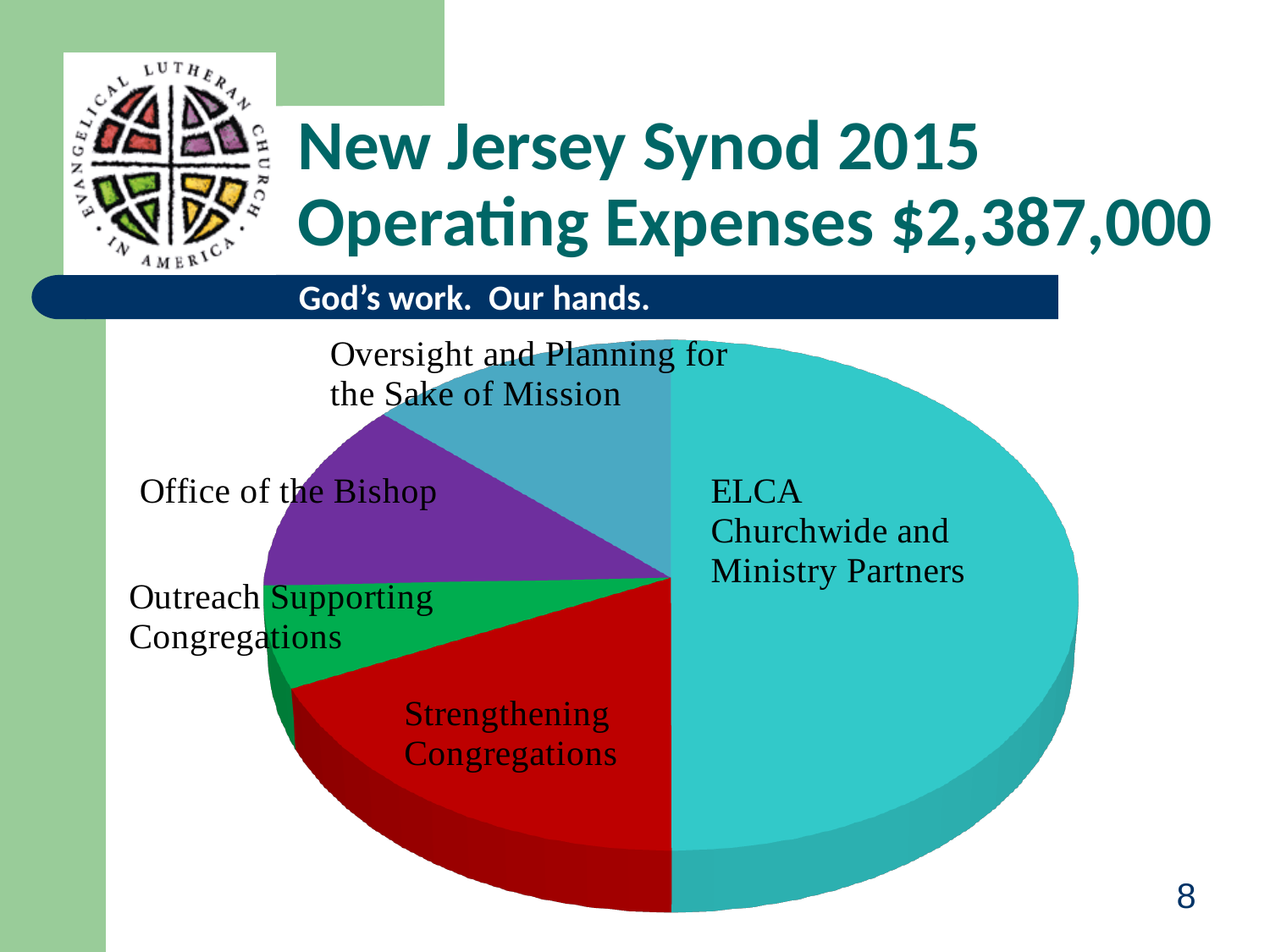
Is the ELCA Churchwide and Ministry Partners slice greater or less than a quarter of the pie? greater What kind of chart is shown on the slide? pie chart Which slice is larger: Office of the Bishop or Outreach Supporting Congregations? Office of the Bishop Which category has the smallest slice of the pie chart? Outreach Supporting Congregations How many slices does the pie chart have? 5 Which category has the largest slice of the pie chart? ELCA Churchwide and Ministry Partners What colour is the Strengthening Congregations slice? red What total operating expenses amount is given in the slide title? $2,387,000 Which slice is larger: Outreach Supporting Congregations or Oversight and Planning for the Sake of Mission? Oversight and Planning for the Sake of Mission Which slice is larger: Strengthening Congregations or Office of the Bishop? Strengthening Congregations